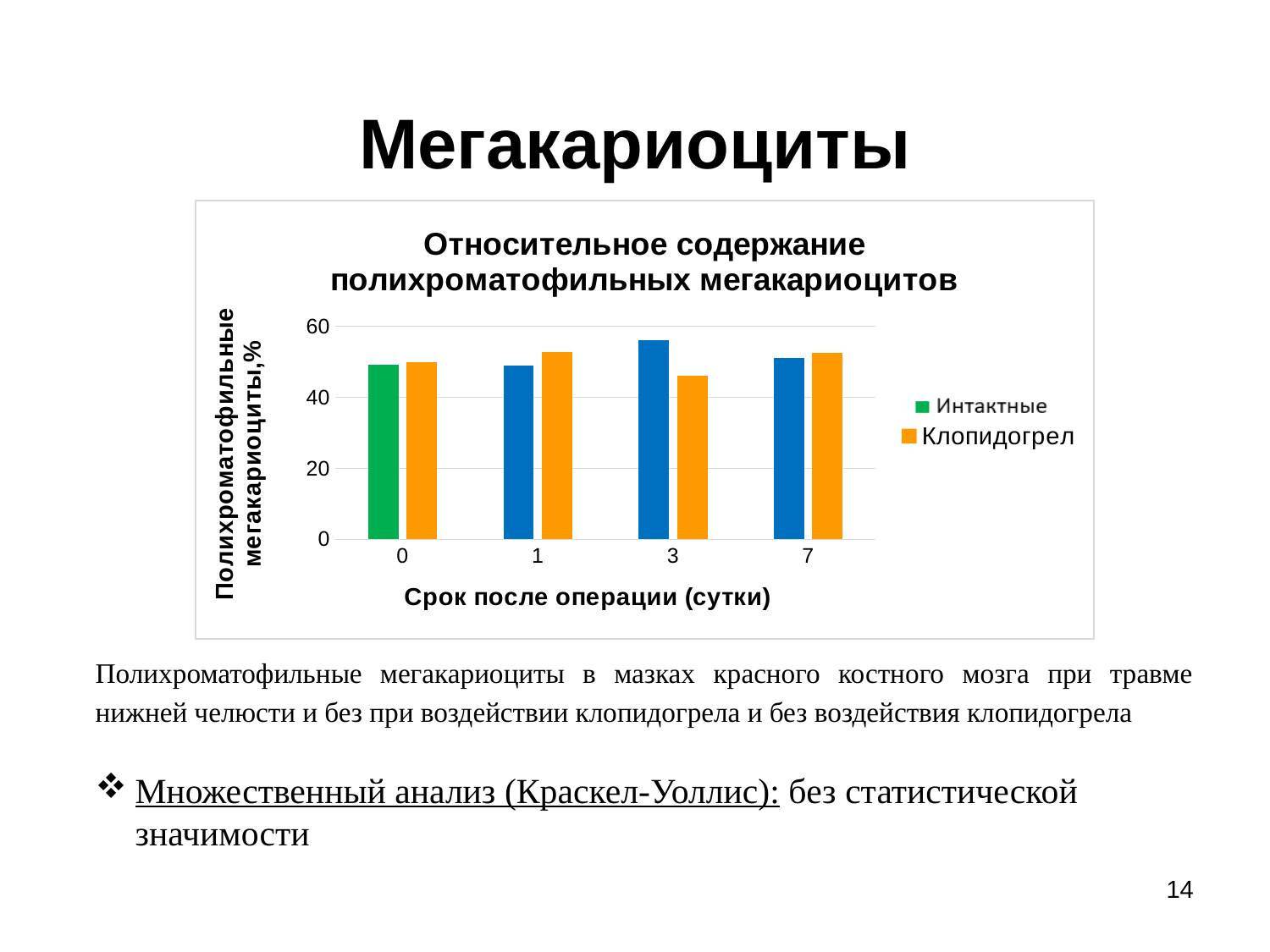
Among the Клопидогрел bars, at which day is the value lowest? 3 How many categories (time points) are shown on the x axis of the chart? 4 What is the title of the chart? Относительное содержание полихроматофильных мегакариоцитов Is the value for Клопидогрел at day 3 greater or less than 40? greater Is the value for Интактные at day 0 greater or less than 40? greater What kind of chart is shown on the slide? bar chart Is the value for Клопидогрел at day 7 greater or less than 60? less At day 1, is the Клопидогрел bar larger or smaller than the other bar at that time point? larger How many series does the chart's legend list? 2 At day 3, is the Клопидогрел bar larger or smaller than the other bar at that time point? smaller What is the x-axis title of the chart? Срок после операции (сутки)